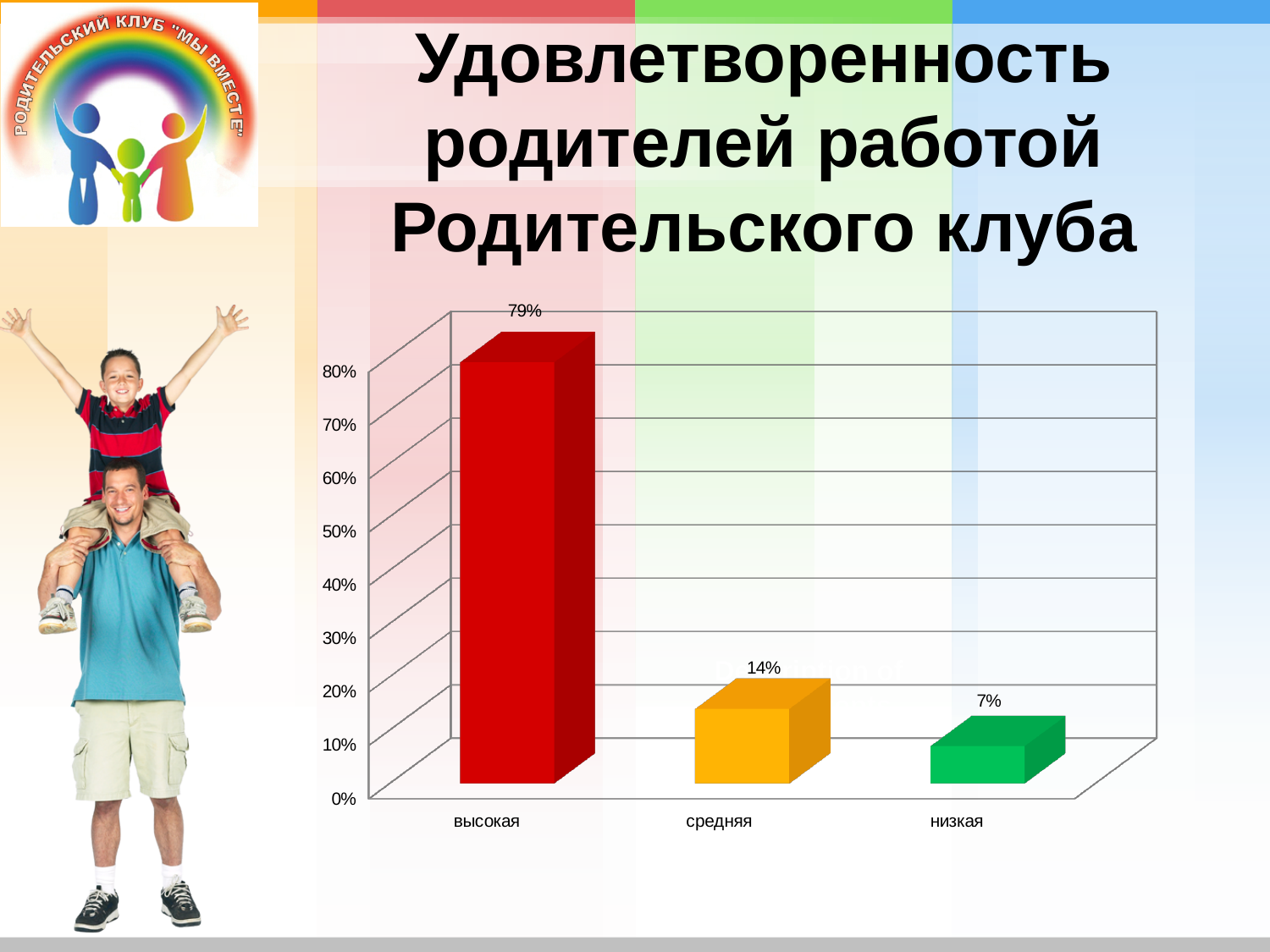
What is the difference between the values for 'высокая' and 'средняя'? 65% Is the value for 'высокая' greater or less than 70%? greater How many categories are shown on the x axis? 3 What colour is the bar for 'средняя'? orange Which category has the highest value? высокая What kind of chart is shown on the slide? bar chart What is the difference between the values for 'средняя' and 'низкая'? 7% Which category has the lowest value? низкая What is the value for the category 'высокая'? 79% What is the value for the category 'низкая'? 7% What is the value for the category 'средняя'? 14% Which is larger, the value for 'средняя' or the value for 'низкая'? средняя